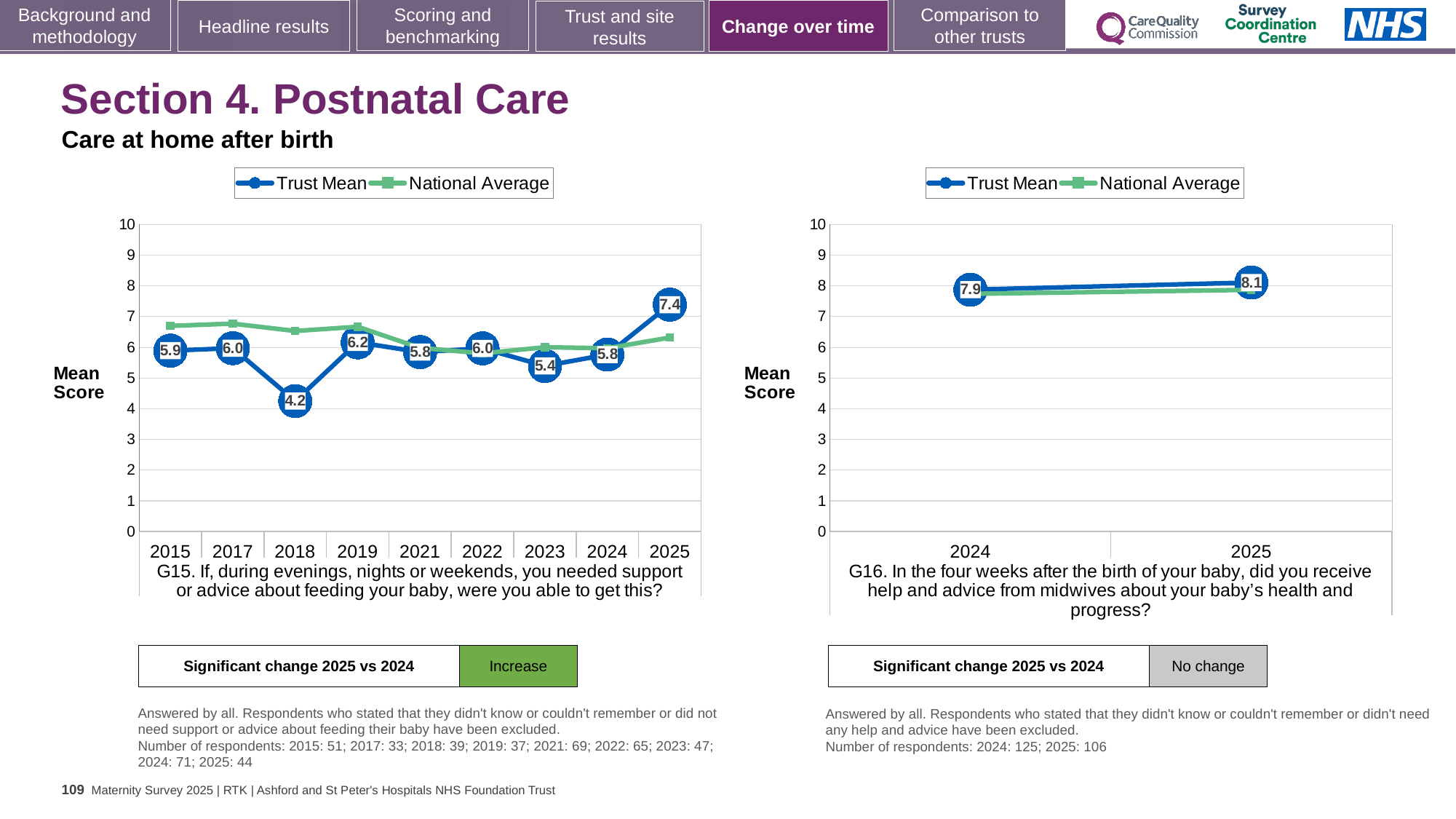
In the left chart (G15), is the National Average for 2015 greater or less than 6? greater In the left chart (G15), is the Trust Mean higher in 2019 or in 2023? 2019 In the left chart (G15), which year has the lowest Trust Mean? 2018 In the right chart (G16), what is the difference between the Trust Mean for 2025 and 2024? 0.2 What type of chart is the right chart (G16)? Line chart In the left chart (G15), what is the Trust Mean for 2018? 4.2 In the left chart (G15), what is the difference between the Trust Mean for 2025 and 2024? 1.6 In the left chart (G15), what is the Trust Mean for 2025? 7.4 In the right chart (G16), what is the Trust Mean for 2024? 7.9 In the left chart (G15), which year has the highest Trust Mean? 2025 How many series does the legend of the right chart (G16) list? 2 How many years are plotted on the x axis of the left chart (G15)? 9